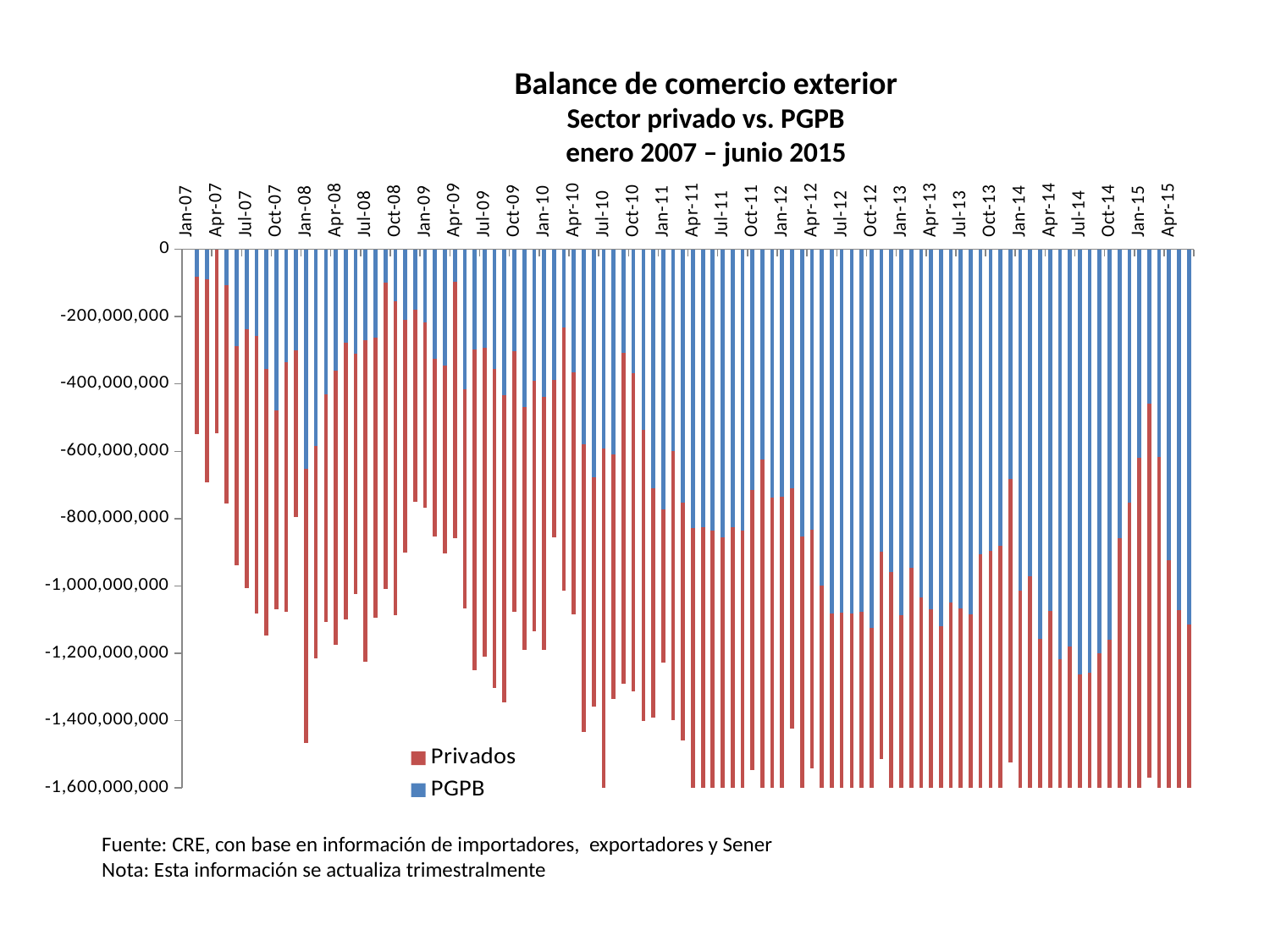
What are the two series named in the legend? Privados and PGPB What period does the chart title say the data covers? enero 2007 – junio 2015 What kind of chart is shown on the slide? Stacked bar chart Is the total stacked value for Jan-07 greater or less than -400,000,000? less Which colour represents the Privados series? Red Is the total stacked value for Jan-15 greater or less than -1,400,000,000? less How many series does the legend list? 2 Which is larger in magnitude, the total stacked bar for Jan-07 or the total stacked bar for Jan-14? Jan-14 What is the lowest value shown on the vertical axis? -1,600,000,000 Does the PGPB (blue) portion of the bars generally grow or shrink from 2007 to 2015? Grow Over the period from Jan-07 to Apr-15, do the stacked bar totals generally become more negative or less negative? More negative Is the PGPB value for Jan-07 greater or less than -200,000,000? greater